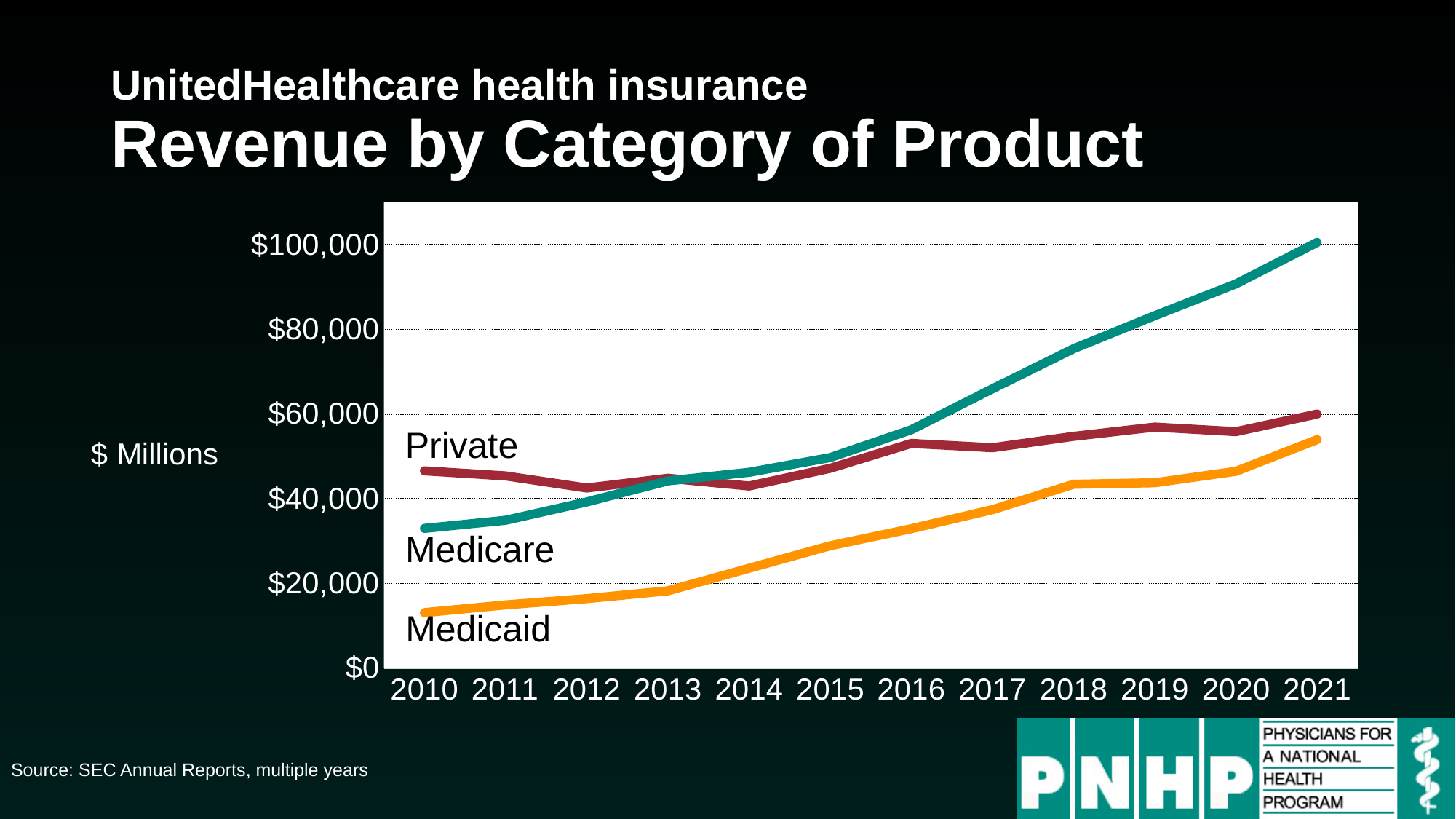
How many product categories (series) are plotted on the chart? 3 What kind of chart is shown on the slide? line chart How many years are shown along the x axis? 12 Is the Medicaid revenue in 2010 greater or less than $20,000? less In 2010, which is larger: Private revenue or Medicare revenue? Private Which category has the lowest revenue in 2021? Medicaid Is the Medicare revenue in 2018 greater or less than $60,000? greater What unit is the y axis labelled in? $ Millions Does Medicare revenue rise or fall from 2010 to 2021? rise In 2021, which is larger: Medicare revenue or Private revenue? Medicare Is the Medicaid revenue in 2021 greater or less than $40,000? greater Which category has the highest revenue in 2021? Medicare